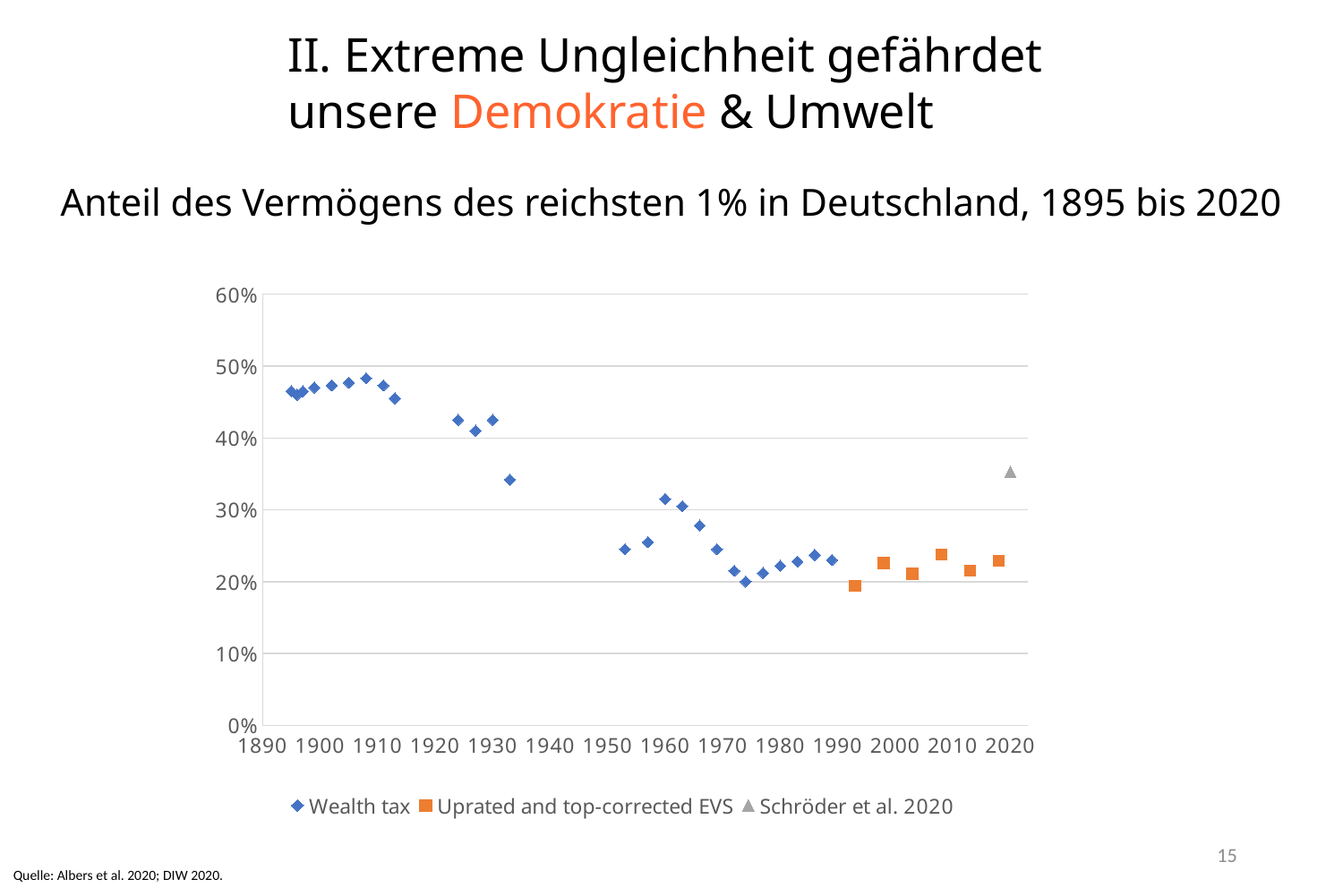
How many points does the Schröder et al. 2020 series have? 1 Is the value of the Schröder et al. 2020 point greater or less than 40%? less Is the Wealth tax value around 1910 greater or less than 40%? greater Is the Wealth tax value around 1975 greater or less than 30%? less Which is higher: the Schröder et al. 2020 point or the last Uprated and top-corrected EVS point? Schröder et al. 2020 Do the Wealth tax values generally rise or fall from 1895 to 1975? fall What kind of chart is shown on the slide? scatter chart How many points does the Uprated and top-corrected EVS series have? 6 How many series does the legend list? 3 What is the title of the chart? Anteil des Vermögens des reichsten 1% in Deutschland, 1895 bis 2020 What are the three series named in the legend? Wealth tax; Uprated and top-corrected EVS; Schröder et al. 2020